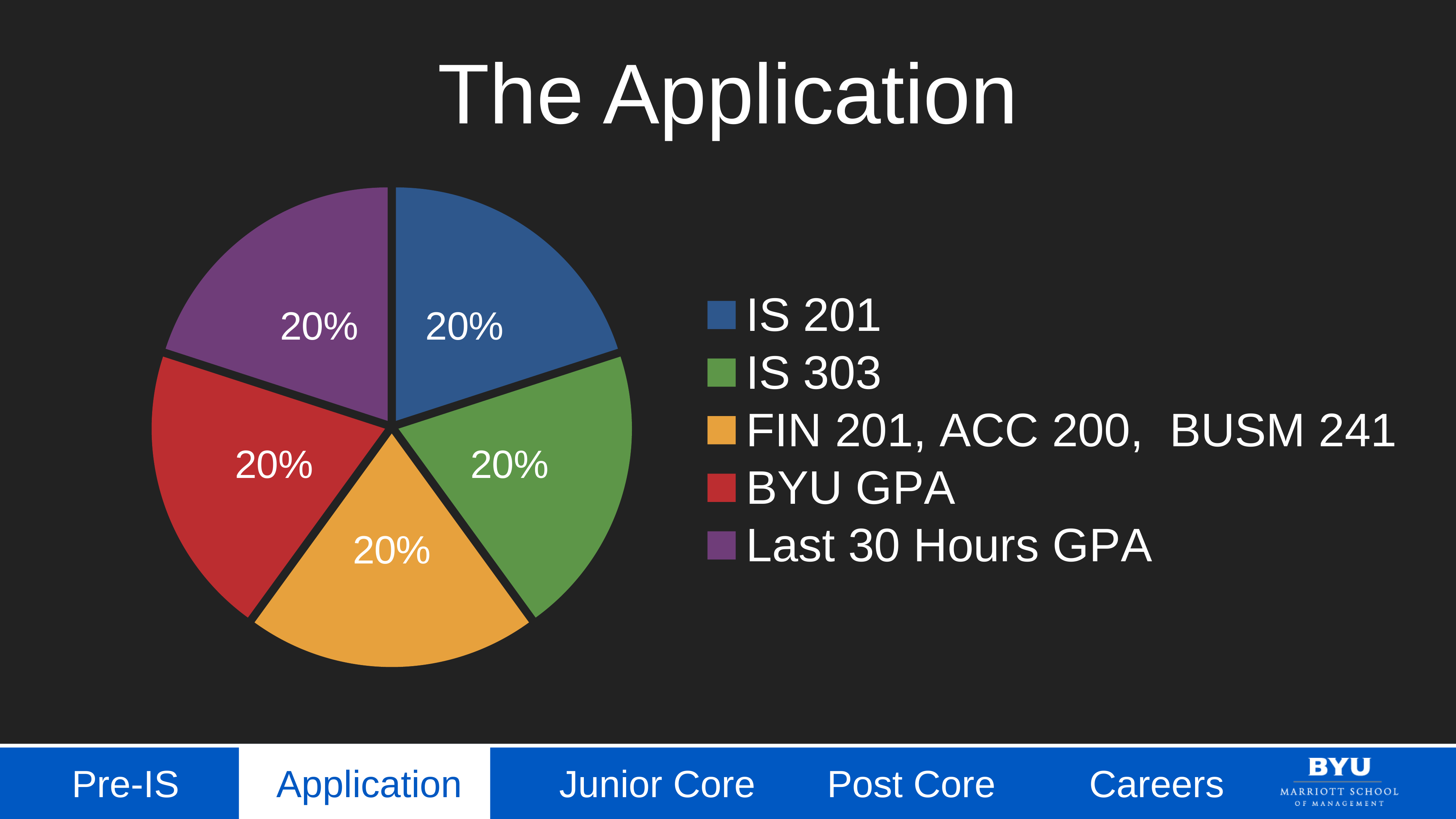
Which legend entry is shown in purple? Last 30 Hours GPA What kind of chart is shown on the slide? pie chart How many entries does the legend list? 5 How many slices does the pie chart have? 5 What is the difference between the IS 201 share and the BYU GPA share? 0% What share of the pie does IS 201 represent? 20% What is the value shown for the FIN 201, ACC 200, BUSM 241 slice? 20% What share of the pie does Last 30 Hours GPA represent? 20% What is the value shown for the IS 303 slice? 20% What is the title of the slide containing the pie chart? The Application What share of the pie does BYU GPA represent? 20%